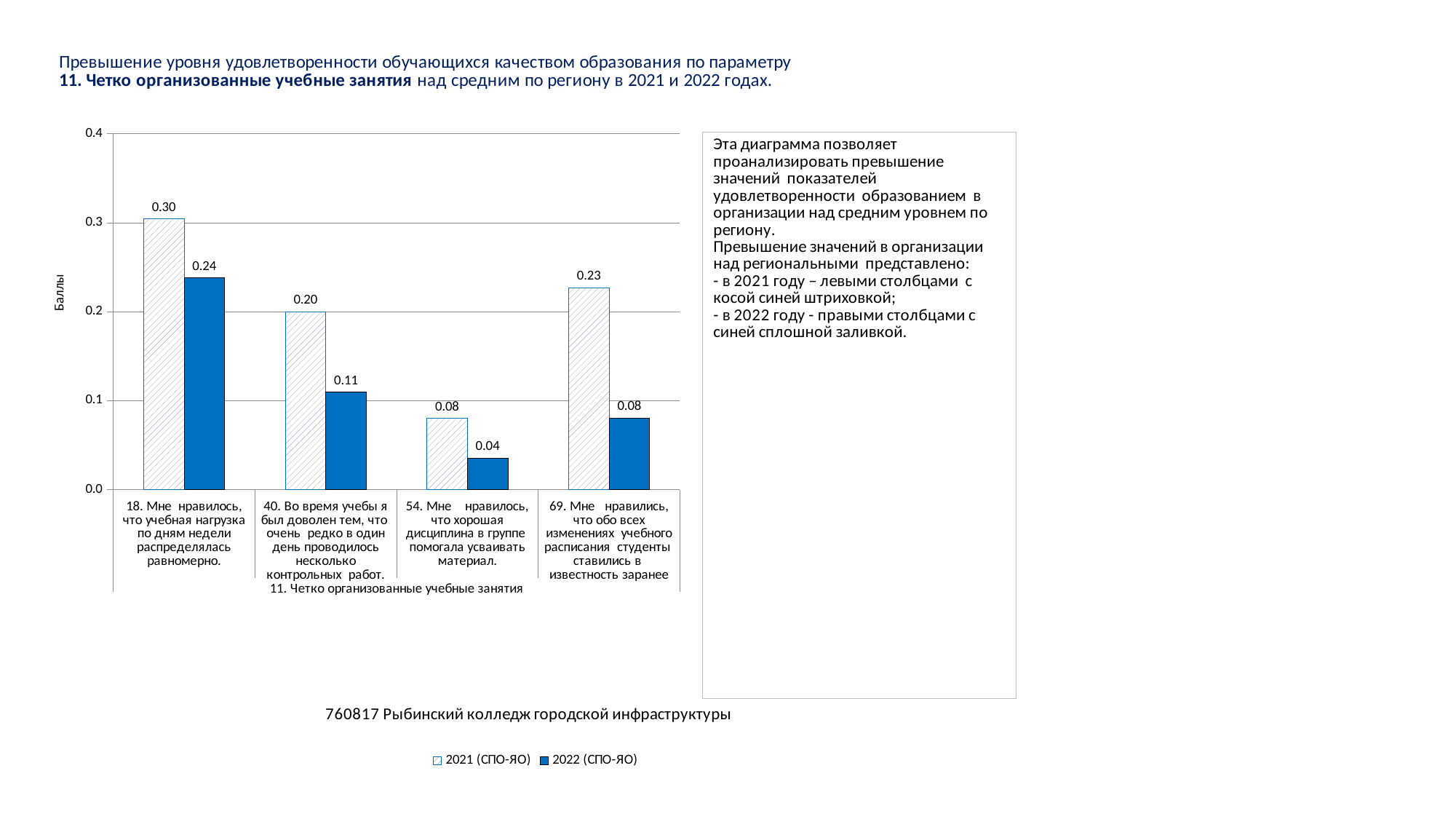
How many categories are shown on the x axis of the chart? 4 What is the 2022 (СПО-ЯО) value for category 40 ("Во время учебы я был доволен тем, что очень редко в один день проводилось несколько контрольных работ")? 0.11 What is the 2022 (СПО-ЯО) value for category 69 ("Мне нравились, что обо всех изменениях учебного расписания студенты ставились в известность заранее")? 0.08 For category 54, which is larger: the 2021 (СПО-ЯО) value or the 2022 (СПО-ЯО) value? 2021 (СПО-ЯО) What is the 2021 (СПО-ЯО) value for category 18 ("Мне нравилось, что учебная нагрузка по дням недели распределялась равномерно")? 0.30 Which category has the highest 2021 (СПО-ЯО) value? 18. Мне нравилось, что учебная нагрузка по дням недели распределялась равномерно. What is the difference between the 2021 and 2022 values for category 18? 0.06 What is the label of the y axis of the chart? Баллы Which category has the lowest 2022 (СПО-ЯО) value? 54. Мне нравилось, что хорошая дисциплина в группе помогала усваивать материал. How many series does the legend list? 2 What kind of chart is shown on the slide? Bar chart What is the difference between the 2021 and 2022 values for category 69? 0.15